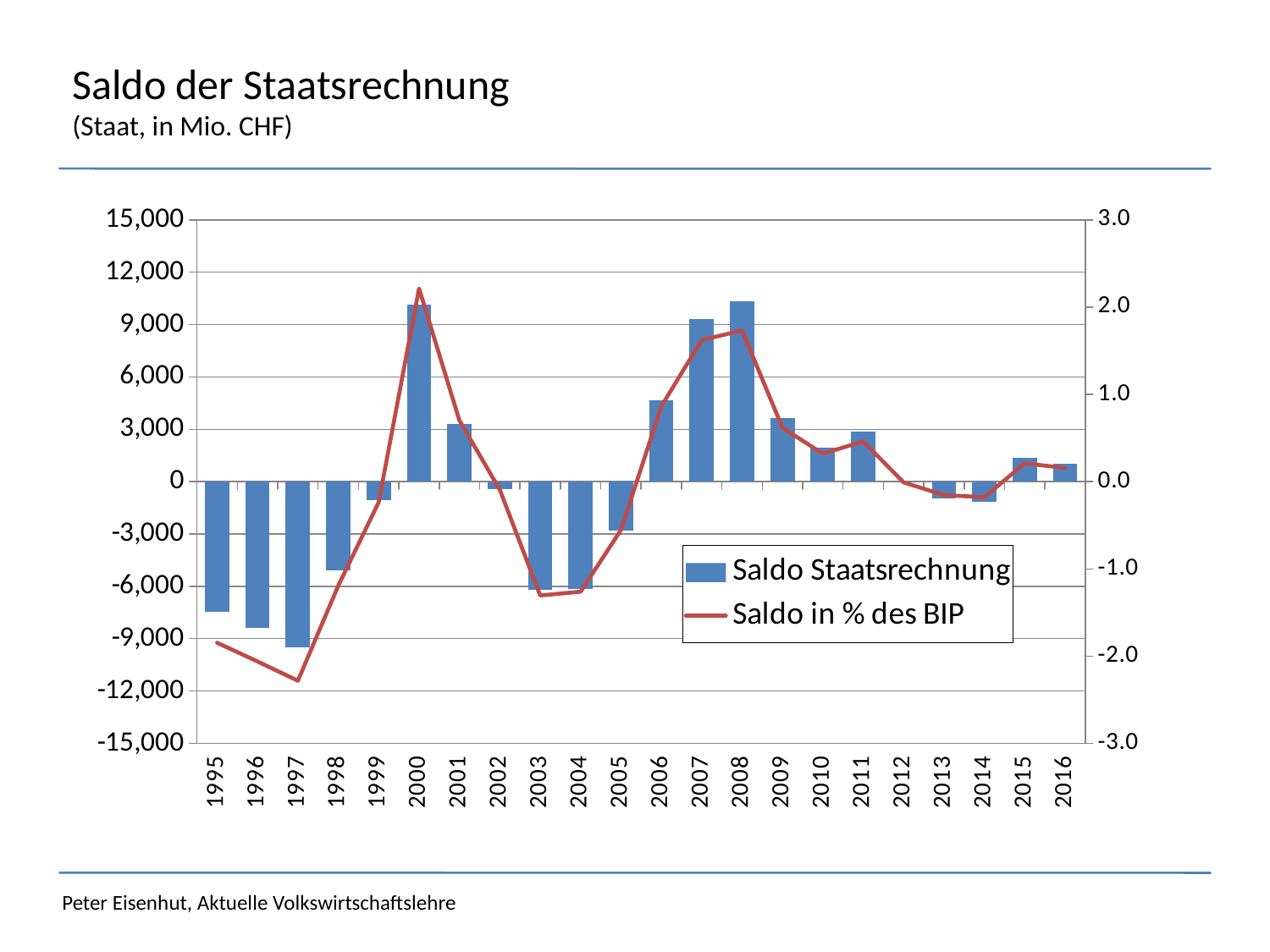
Is the Saldo Staatsrechnung bar for 1997 greater or less than -9,000? less Is the Saldo in % des BIP value for 2000 greater or less than 2.0? greater Which year has the lowest (most negative) Saldo Staatsrechnung bar? 1997 In which year does the Saldo in % des BIP line reach its highest point? 2000 Do the Saldo Staatsrechnung bars rise or fall from 2008 to 2010? fall What is the title of the chart on the slide? Saldo der Staatsrechnung What kind of chart is shown on the slide? A combined bar and line chart Is the Saldo Staatsrechnung bar for 2000 greater or less than 9,000? greater Which year has the larger Saldo Staatsrechnung bar, 2007 or 2009? 2007 In which year does the Saldo in % des BIP line reach its lowest point? 1997 How many years are shown on the x axis? 22 How many series does the legend list? 2